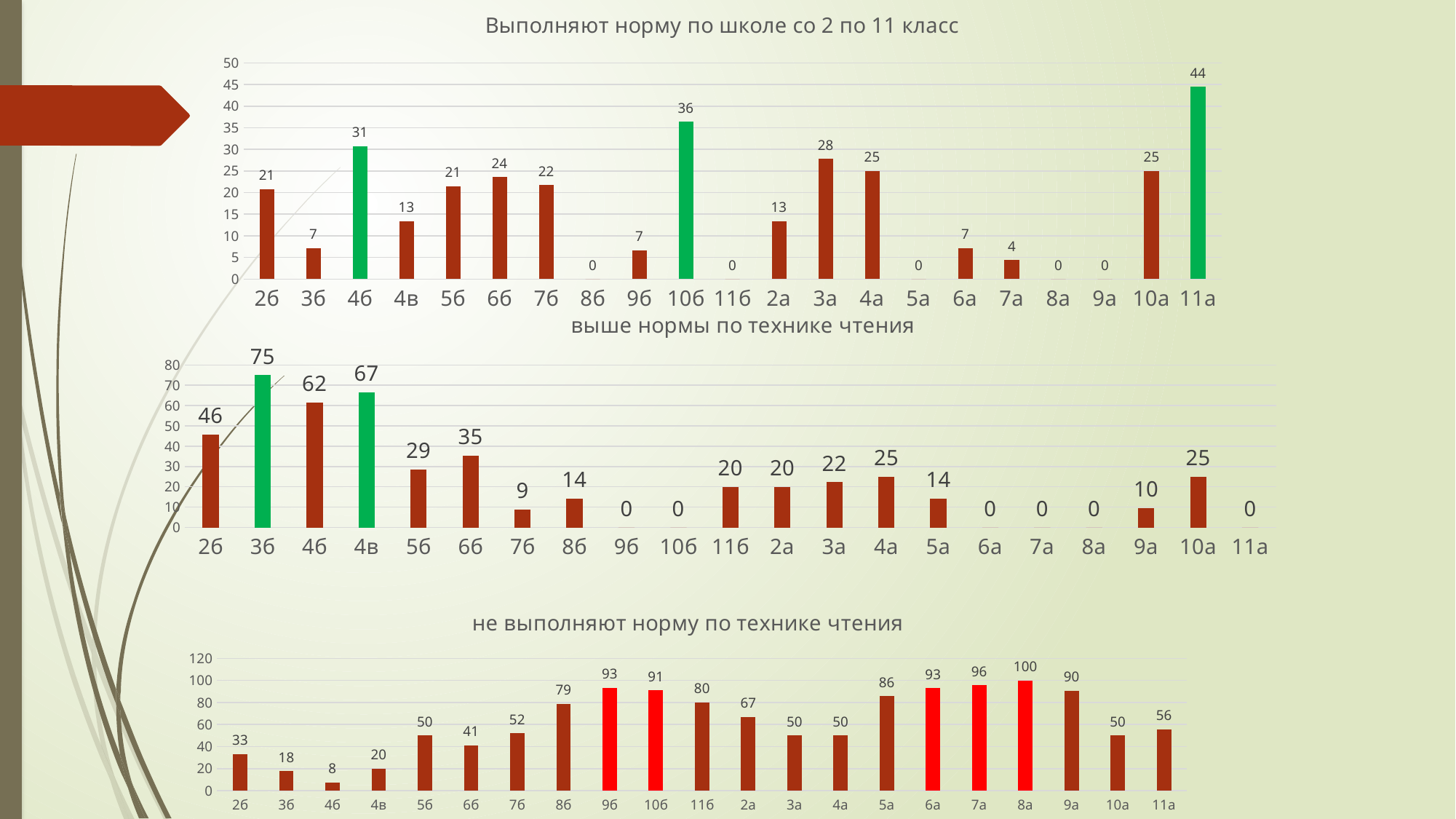
In the chart 'не выполняют норму по технике чтения', what is the value for 8а? 100 In the chart 'выше нормы по технике чтения', which is larger, the value for 2б or the value for 6б? 2б In the chart 'Выполняют норму по школе со 2 по 11 класс', what is the difference between the values for 4б and 3б? 24 In the chart 'не выполняют норму по технике чтения', which class has the lowest value? 4б In the chart 'Выполняют норму по школе со 2 по 11 класс', what is the value for 10б? 36 In the chart 'Выполняют норму по школе со 2 по 11 класс', which class has the highest value? 11а In the chart 'не выполняют норму по технике чтения', what is the difference between the values for 9б and 2б? 60 In the chart 'выше нормы по технике чтения', which class has the highest value? 3б How many classes are shown on the x axis of the chart 'не выполняют норму по технике чтения'? 21 In the chart 'не выполняют норму по технике чтения', how many bars are coloured bright red? 5 What type of chart is 'выше нормы по технике чтения'? Bar chart In the chart 'выше нормы по технике чтения', what is the value for 4в? 67